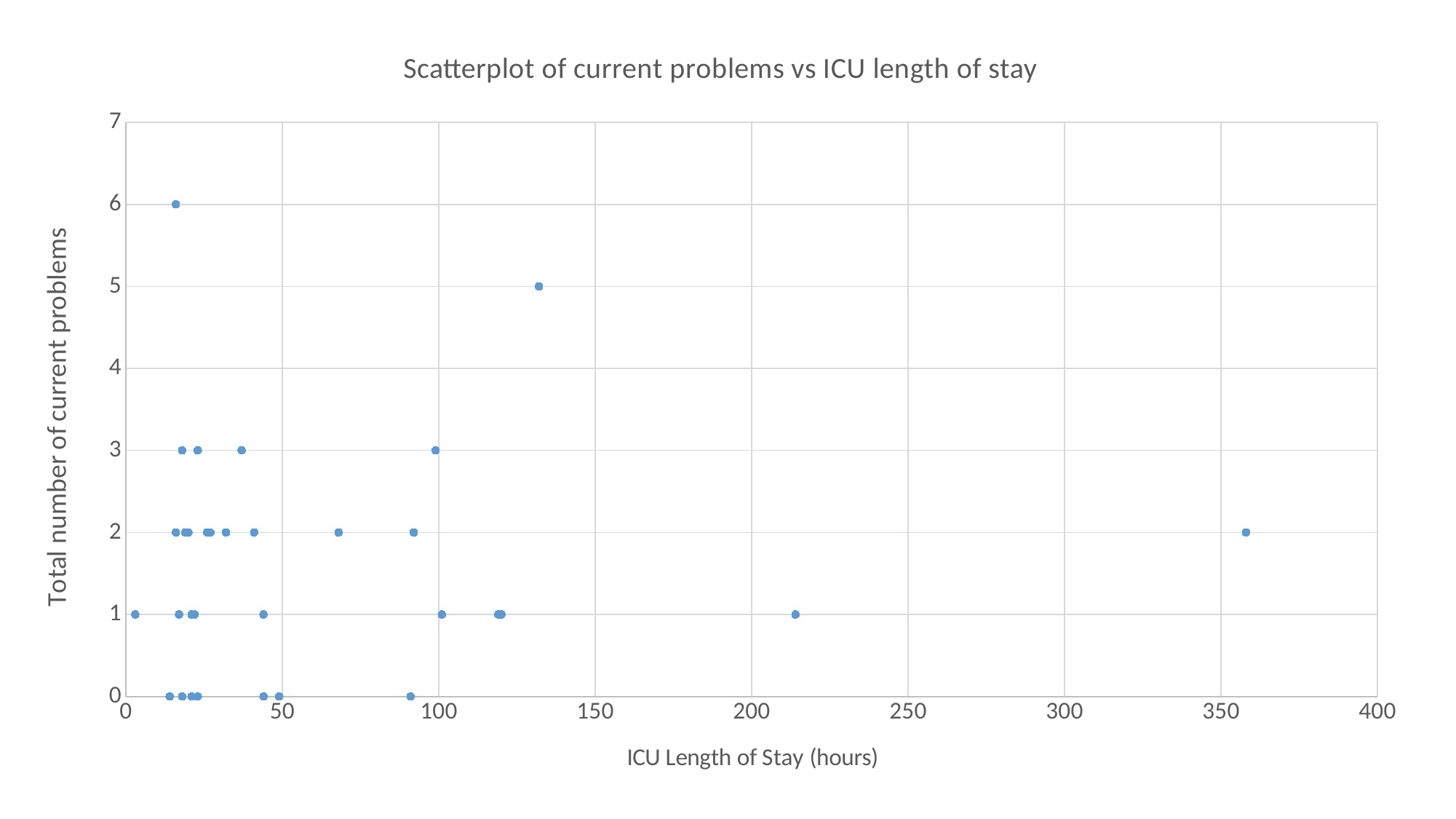
How many points have a total of 5 current problems? 1 How many current problems does the point with the longest ICU length of stay have? 2 Is the ICU length of stay for the point with 6 current problems greater or less than 50 hours? less What is the label of the x axis? ICU Length of Stay (hours) What kind of chart is shown on the slide? Scatter plot How many current problems does the point with an ICU length of stay just over 200 hours have? 1 How many points have a total of 3 current problems? 4 What is the title of the chart? Scatterplot of current problems vs ICU length of stay Is the ICU length of stay for the point with 5 current problems greater or less than 100 hours? greater What is the highest total number of current problems plotted for any point? 6 Is the ICU length of stay for the point with the longest stay greater or less than 350 hours? greater Which has more current problems: the point with the longest ICU stay or the point with an ICU stay of about 130 hours? The point with an ICU stay of about 130 hours